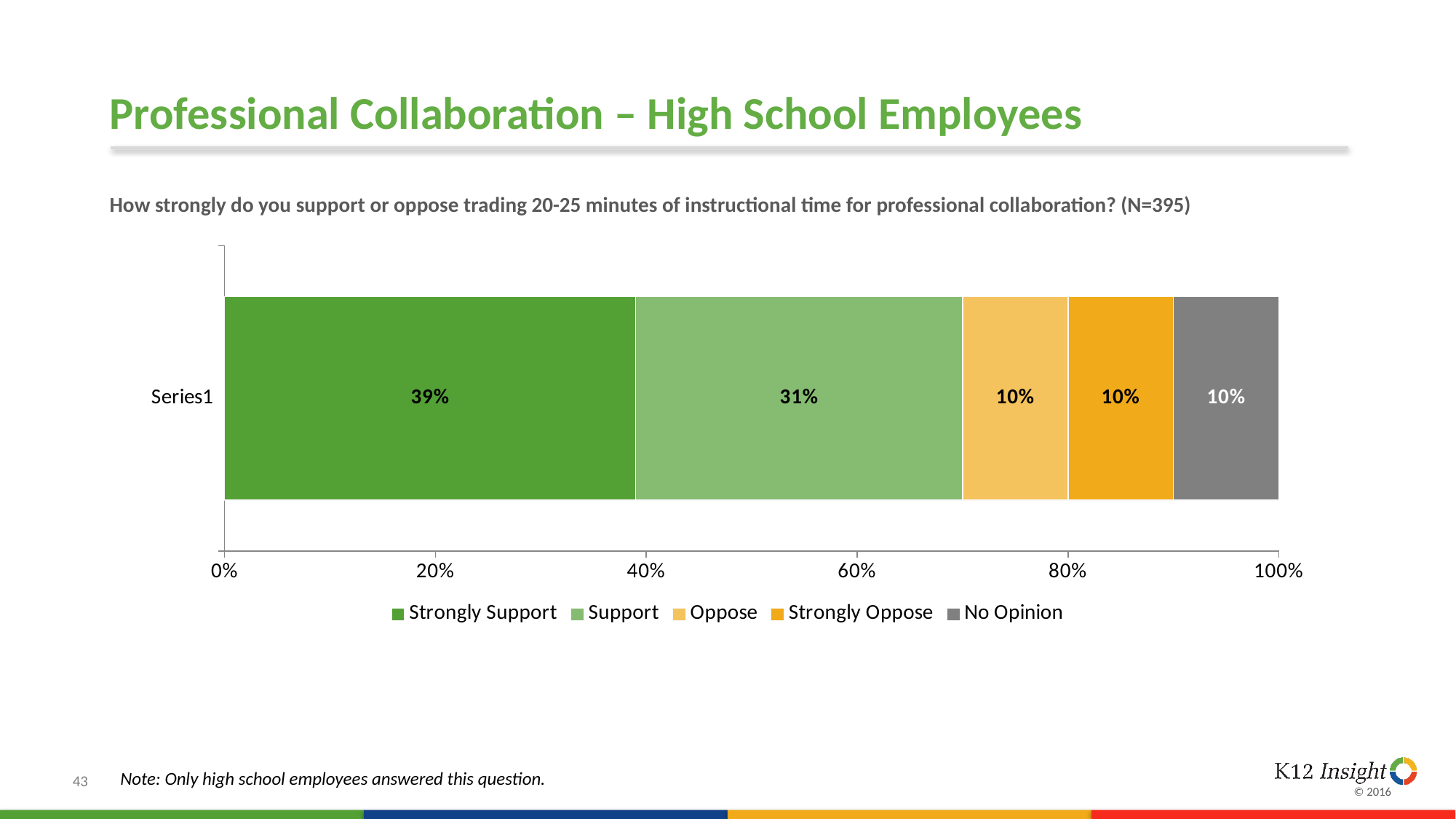
Which is larger, the Support share or the Oppose share? Support What is the total of all segments in the bar? 100% Which response category has the largest share of the bar? Strongly Support What percentage of respondents chose No Opinion? 10% What percentage of respondents chose Strongly Support? 39% How many response categories does the legend list? 5 What colour is the Strongly Oppose segment? Orange What percentage of respondents chose Support? 31% What is the combined percentage of Strongly Support and Support? 70% What kind of chart is shown on the slide? Stacked bar chart What is the difference between the Strongly Support and Support percentages? 8% What is the sample size (N) stated in the question text above the chart? 395